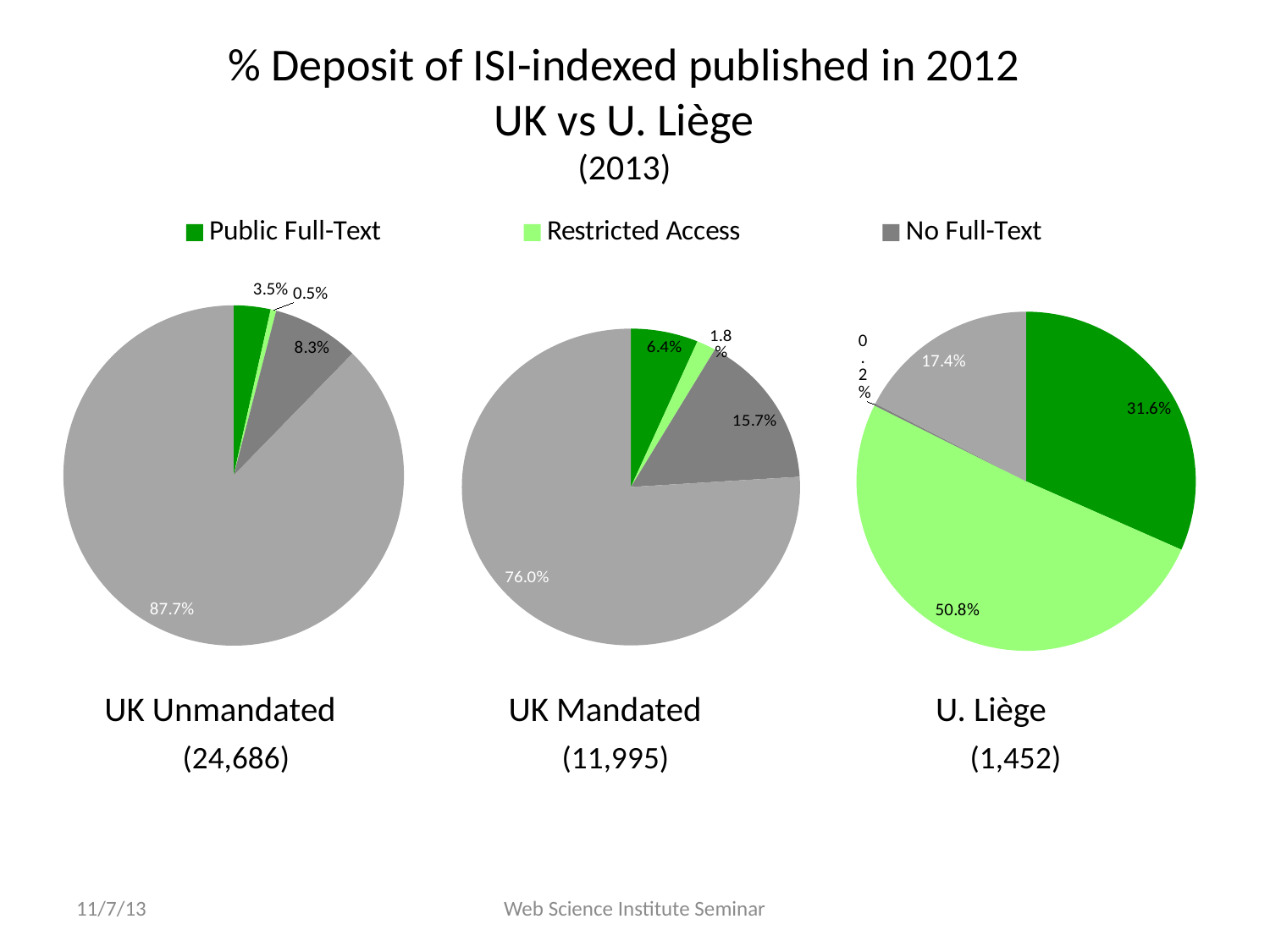
In the UK Unmandated pie chart, what is the value for Restricted Access? 0.5% In the UK Mandated pie chart, what is the value for Public Full-Text? 6.4% In the UK Mandated pie chart, what is the value for Restricted Access? 1.8% What kind of charts are shown on the slide? Pie charts How much larger is the Public Full-Text share in the UK Mandated pie chart than in the UK Unmandated pie chart? 2.9 percentage points In the UK Unmandated pie chart, what is the value of the largest slice? 87.7% Which has a larger Public Full-Text share, the UK Mandated pie chart or the UK Unmandated pie chart? UK Mandated In the UK Unmandated pie chart, what is the value for Public Full-Text? 3.5% In the U. Liège pie chart, what is the value for Restricted Access? 50.8% How many entries does the legend list? 3 In the U. Liège pie chart, what is the value for Public Full-Text? 31.6% In the U. Liège pie chart, which category has the largest slice? Restricted Access